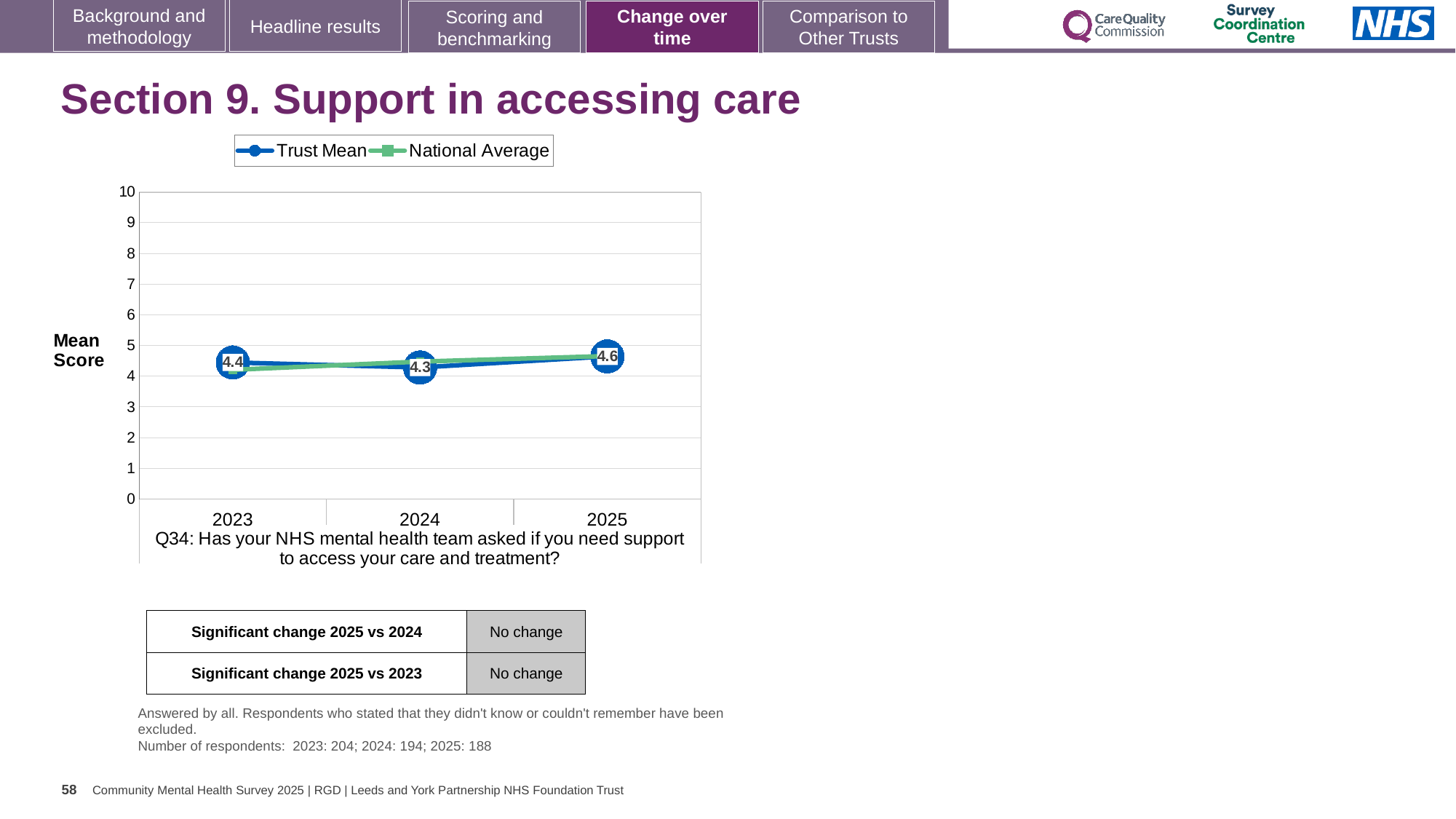
What is the Trust Mean score for 2023? 4.4 What is the difference between the Trust Mean score in 2025 and in 2024? 0.3 What is the Trust Mean score for 2025? 4.6 Is the Trust Mean score higher in 2023 or in 2025? 2025 Does the Trust Mean score rise or fall from 2024 to 2025? Rise How many years are plotted on the x axis? 3 What kind of chart is shown on the slide? Line chart How many series does the legend list? 2 In which year is the Trust Mean score lowest? 2024 In which year is the Trust Mean score highest? 2025 What is the Trust Mean score for 2024? 4.3 Is the National Average value for 2023 greater or less than 5? less